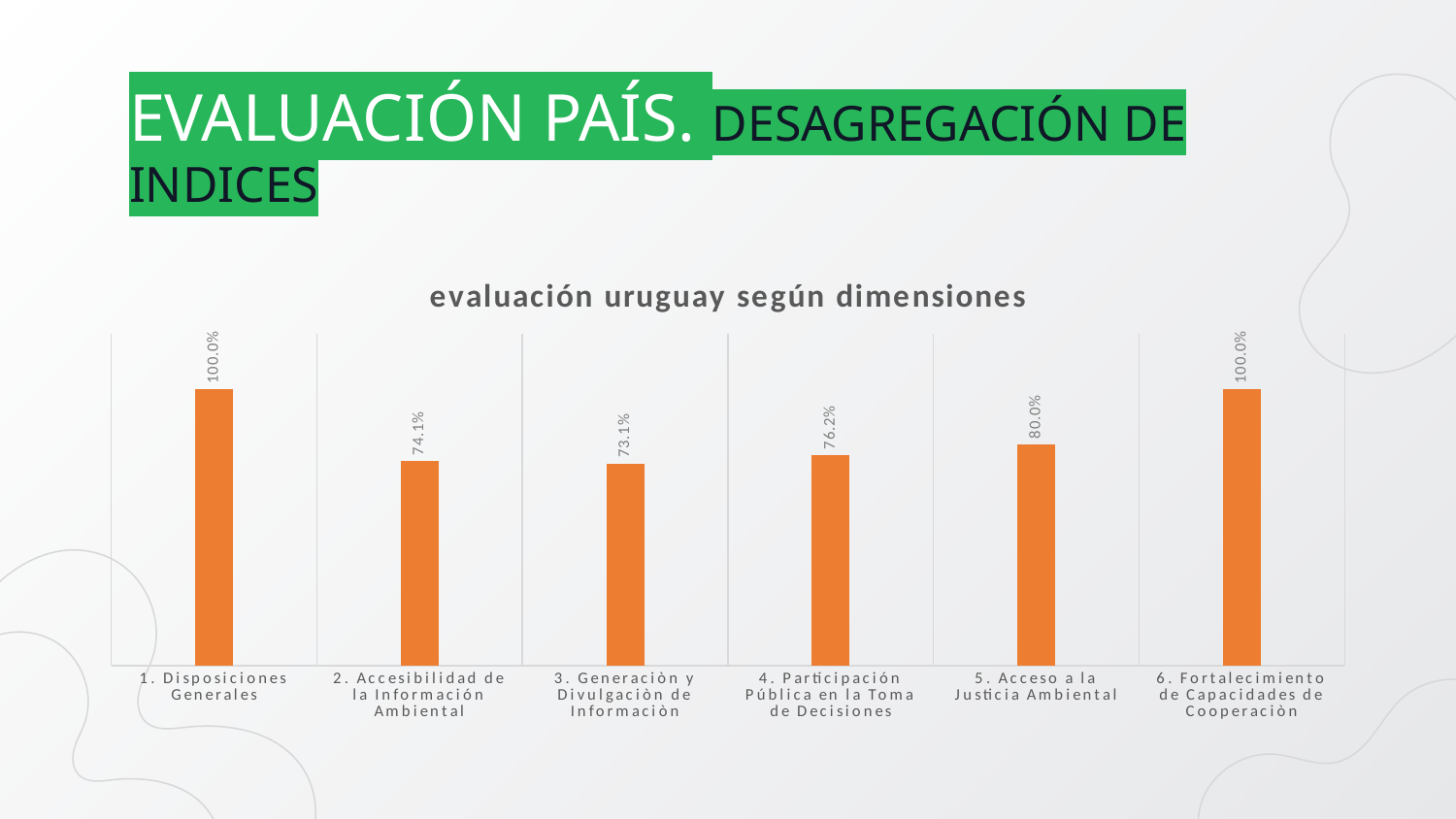
What is the value for '5. Acceso a la Justicia Ambiental'? 80.0% Which is larger, the value for '4. Participación Pública en la Toma de Decisiones' or the value for '3. Generaciòn y Divulgaciòn de Informaciòn'? 4. Participación Pública en la Toma de Decisiones What is the value for '4. Participación Pública en la Toma de Decisiones'? 76.2% Which category has the lowest value? 3. Generaciòn y Divulgaciòn de Informaciòn What kind of chart is shown on the slide? Bar chart What is the value for '3. Generaciòn y Divulgaciòn de Informaciòn'? 73.1% What is the value for '1. Disposiciones Generales'? 100.0% What is the title of the chart? evaluación uruguay según dimensiones What is the difference between the values for '5. Acceso a la Justicia Ambiental' and '2. Accesibilidad de la Información Ambiental'? 5.9% What is the value for '2. Accesibilidad de la Información Ambiental'? 74.1% How many categories are shown in the chart? 6 What is the value for '6. Fortalecimiento de Capacidades de Cooperaciòn'? 100.0%